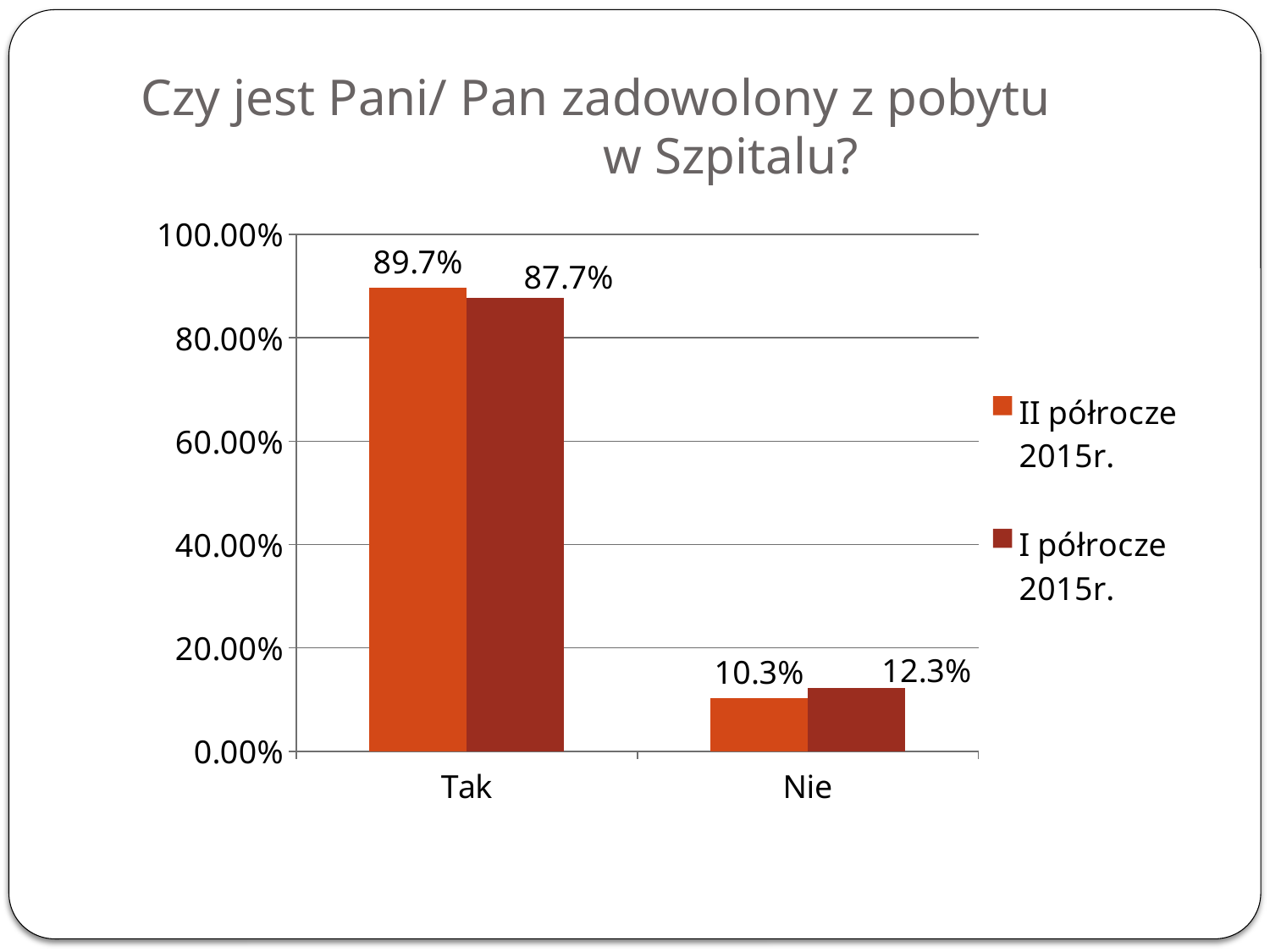
What is the value for "Tak" in the "I półrocze 2015r." series? 87.7% How many series does the legend list? 2 What is the difference between the "II półrocze 2015r." and "I półrocze 2015r." values for "Tak"? 2.0% What kind of chart is shown on the slide? Bar chart What is the value for "Nie" in the "I półrocze 2015r." series? 12.3% What is the value for "Nie" in the "II półrocze 2015r." series? 10.3% How many categories are shown on the x axis? 2 For "Nie", which series has the larger value: "II półrocze 2015r." or "I półrocze 2015r."? I półrocze 2015r. Which category has the lowest value in the "I półrocze 2015r." series? Nie Which category has the highest value in the "II półrocze 2015r." series? Tak What is the value for "Tak" in the "II półrocze 2015r." series? 89.7% What is the difference between the "I półrocze 2015r." and "II półrocze 2015r." values for "Nie"? 2.0%